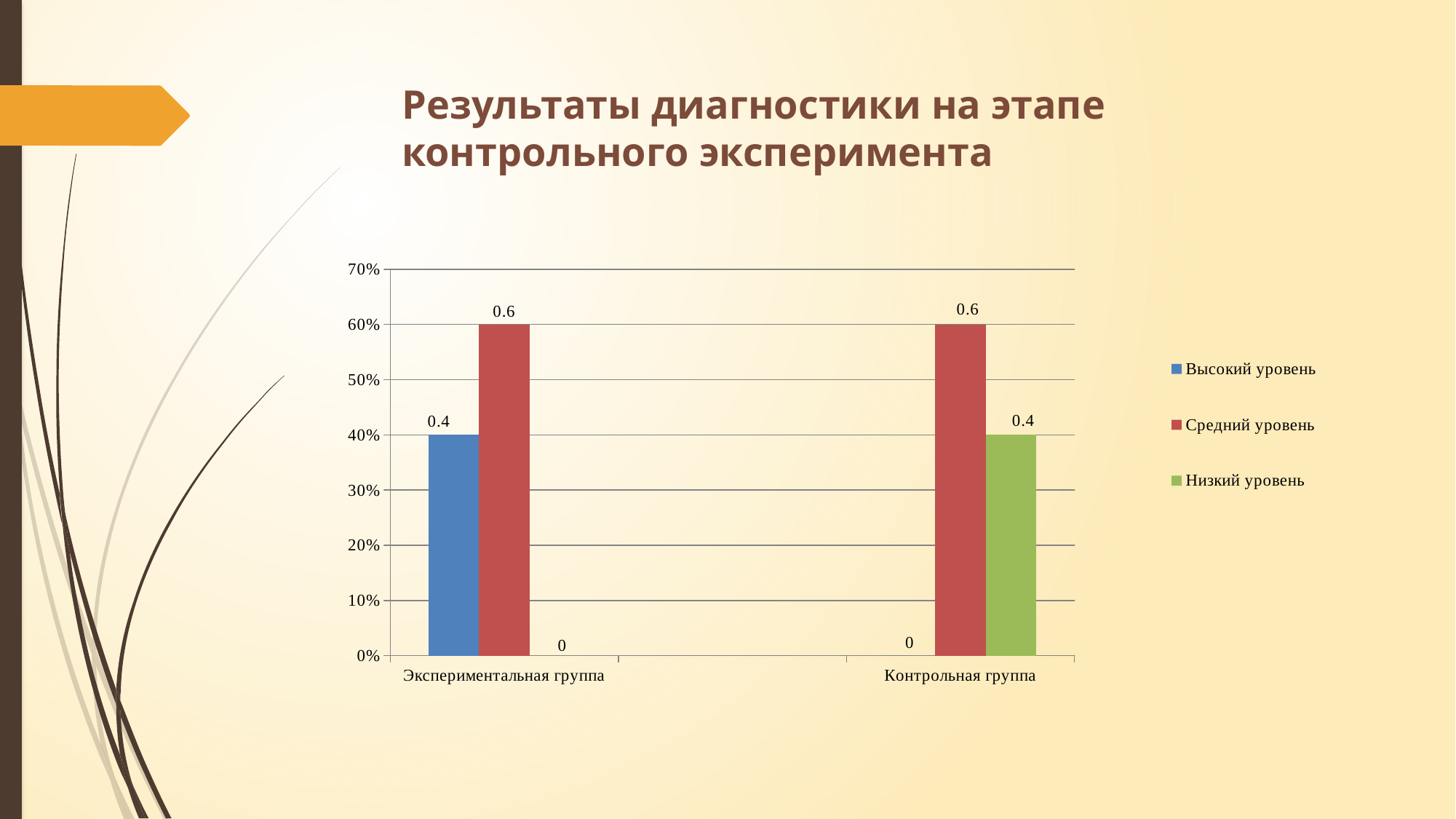
What is the value of Средний уровень for Контрольная группа? 0.6 What kind of chart is shown on the slide? Bar chart Which is larger: Низкий уровень for Контрольная группа or Низкий уровень for Экспериментальная группа? Контрольная группа What is the value of Высокий уровень for Экспериментальная группа? 0.4 What is the value of Высокий уровень for Контрольная группа? 0 What is the value of Низкий уровень for Экспериментальная группа? 0 What is the difference between Средний уровень and Высокий уровень for Экспериментальная группа? 0.2 How many groups are shown on the x axis? 2 Which series has the lowest value for Контрольная группа? Высокий уровень What colour represents Средний уровень in the legend? Red How many series does the legend list? 3 Which series has the highest value for Экспериментальная группа? Средний уровень